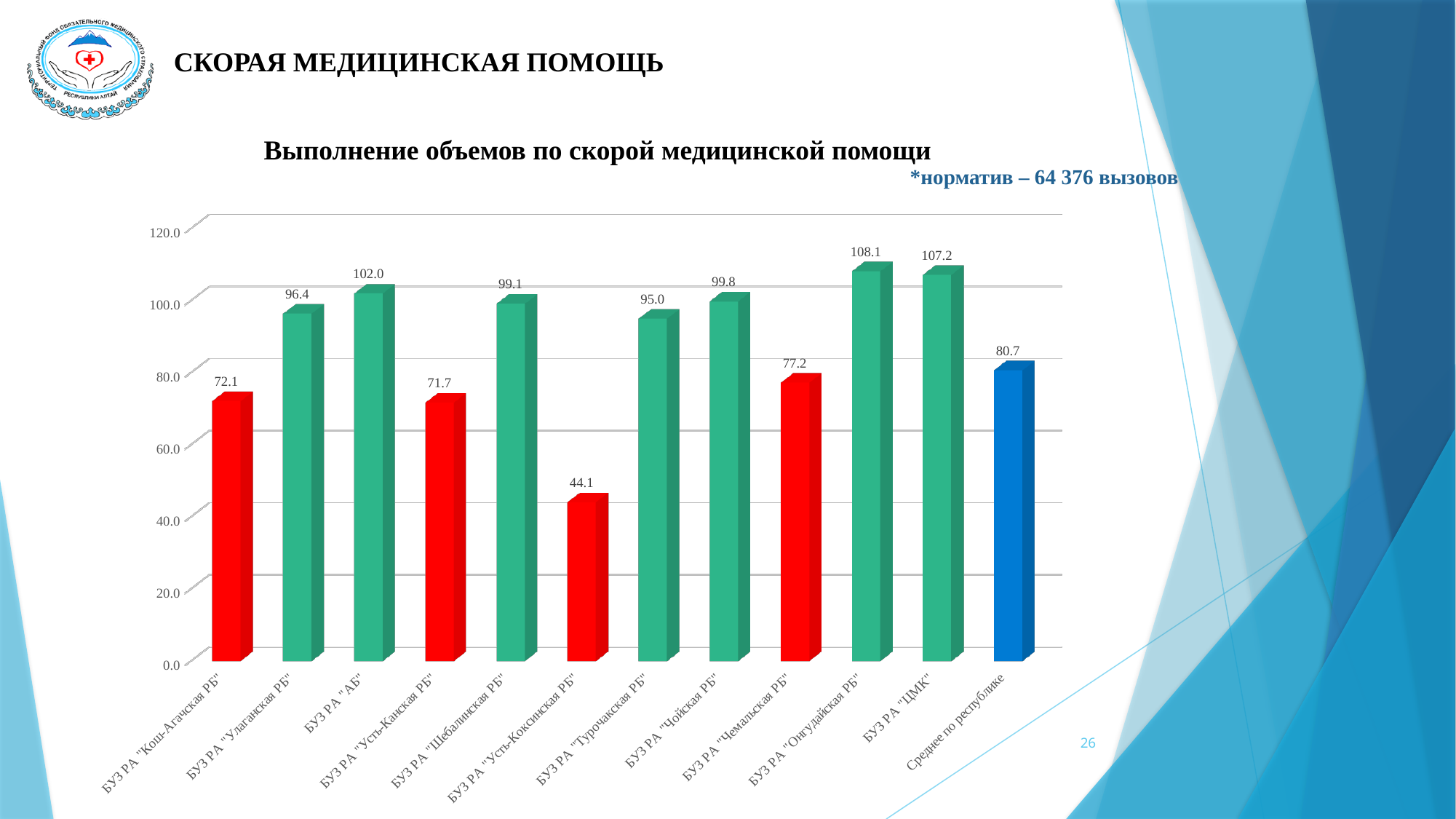
Which is larger, the value for БУЗ РА "Улаганская РБ" or БУЗ РА "Турочакская РБ"? БУЗ РА "Улаганская РБ" How many categories are shown on the x axis? 12 What is the value for БУЗ РА "Онгудайская РБ"? 108.1 What is the title of the chart? Выполнение объемов по скорой медицинской помощи What is the difference between the values for БУЗ РА "Онгудайская РБ" and БУЗ РА "ЦМК"? 0.9 What kind of chart is shown on the slide? Bar chart Which category has the lowest value? БУЗ РА "Усть-Коксинская РБ" Which category has the highest value? БУЗ РА "Онгудайская РБ" What is the difference between the values for БУЗ РА "АБ" and БУЗ РА "Усть-Коксинская РБ"? 57.9 What is the value shown for Среднее по республике? 80.7 What is the value for БУЗ РА "Чемальская РБ"? 77.2 What is the value for БУЗ РА "Усть-Коксинская РБ"? 44.1